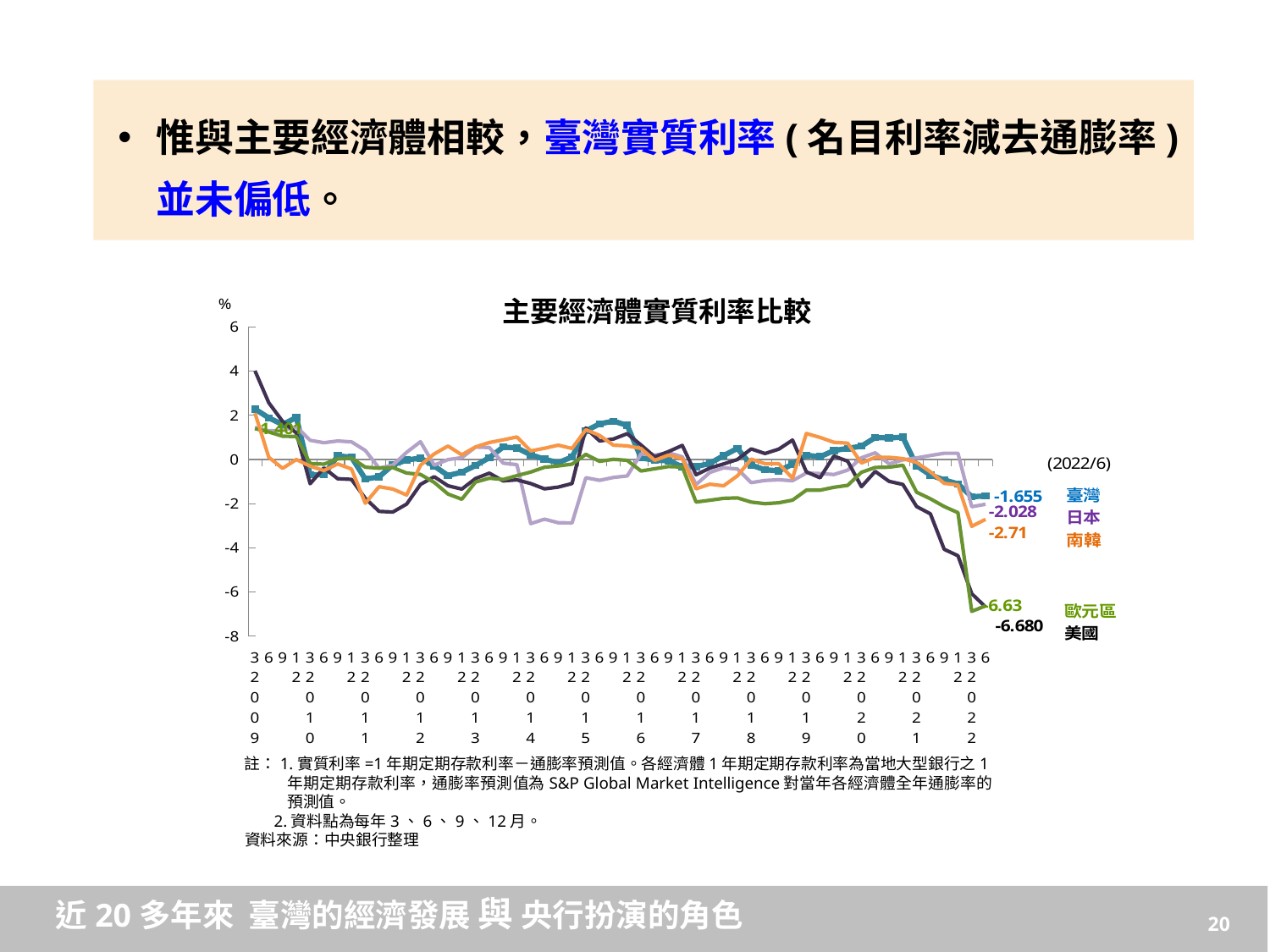
What is the value for 歐元區 at 2022/6? -6.63 What is the value for 南韓 at 2022/6? -2.71 Which economy has the highest real interest rate at 2022/6? 臺灣 What is the value for 日本 at 2022/6? -2.028 What is the difference between the 2022/6 values for 臺灣 and 南韓? 1.055 What is the title of the chart? 主要經濟體實質利率比較 Does the line for 歐元區 rise or fall over the final part of the chart (2021 to 2022/6)? fall Which economy has the lowest real interest rate at 2022/6? 美國 How many economies (series) are plotted in the chart? 5 What is the value for 臺灣 at 2022/6? -1.655 What kind of chart is shown on the slide? line chart What is the value for 美國 at 2022/6? -6.680